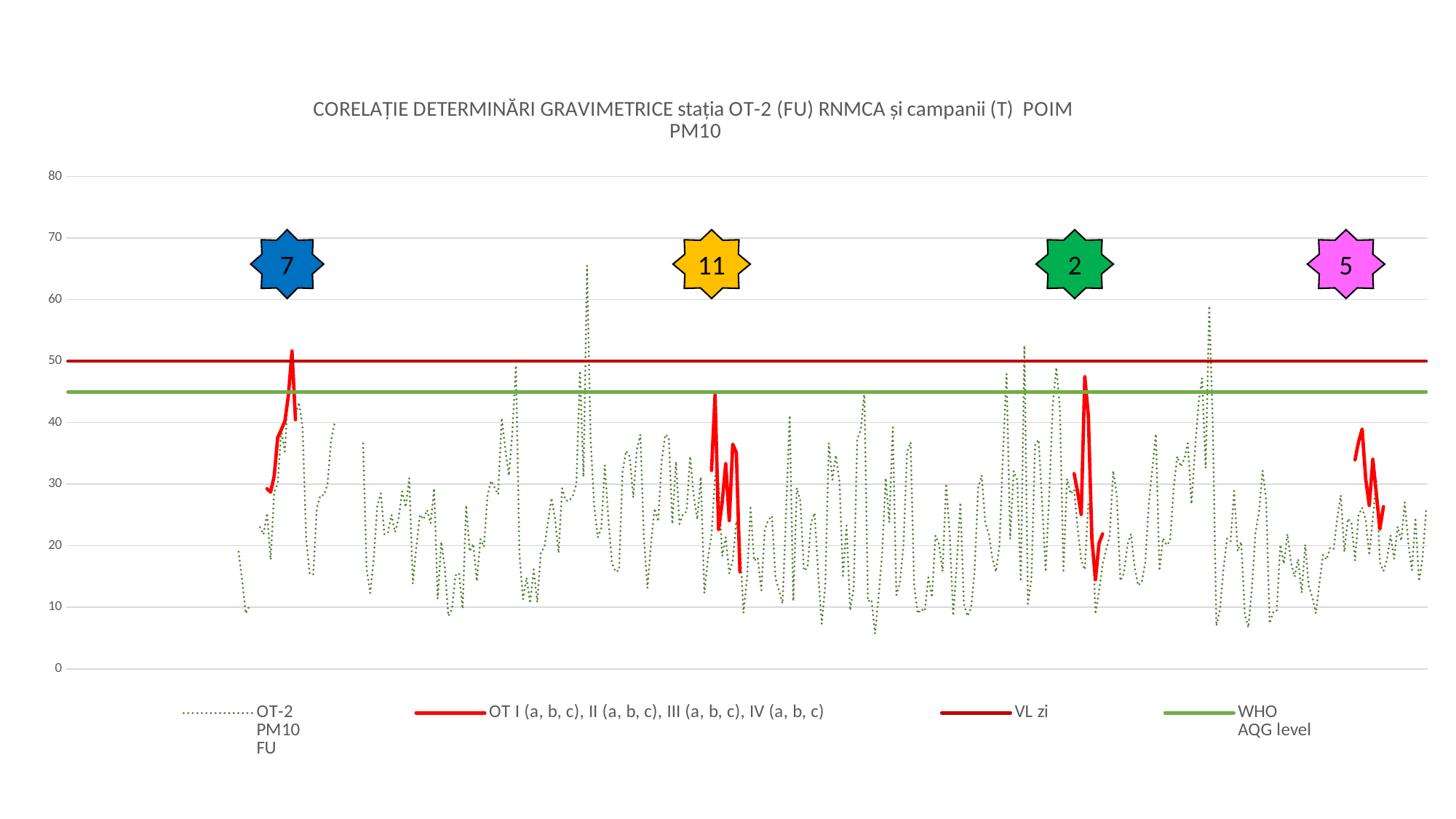
Is the highest peak of the OT-2 PM10 FU series greater or less than 60? greater What value does the VL zi line sit at on the vertical axis? 50 Is the lowest point of the OT-2 PM10 FU series greater or less than 10? less Which legend entry is drawn as a dotted green line? OT-2 PM10 FU What kind of chart is shown on the slide? line chart Is the WHO AQG level line greater or less than 40? greater Which is higher on the chart, the VL zi line or the WHO AQG level line? VL zi What is the maximum value shown on the vertical axis? 80 What is the title of the chart? CORELAȚIE DETERMINĂRI GRAVIMETRICE stația OT-2 (FU) RNMCA și campanii (T) POIM PM10 How many series does the legend list? 4